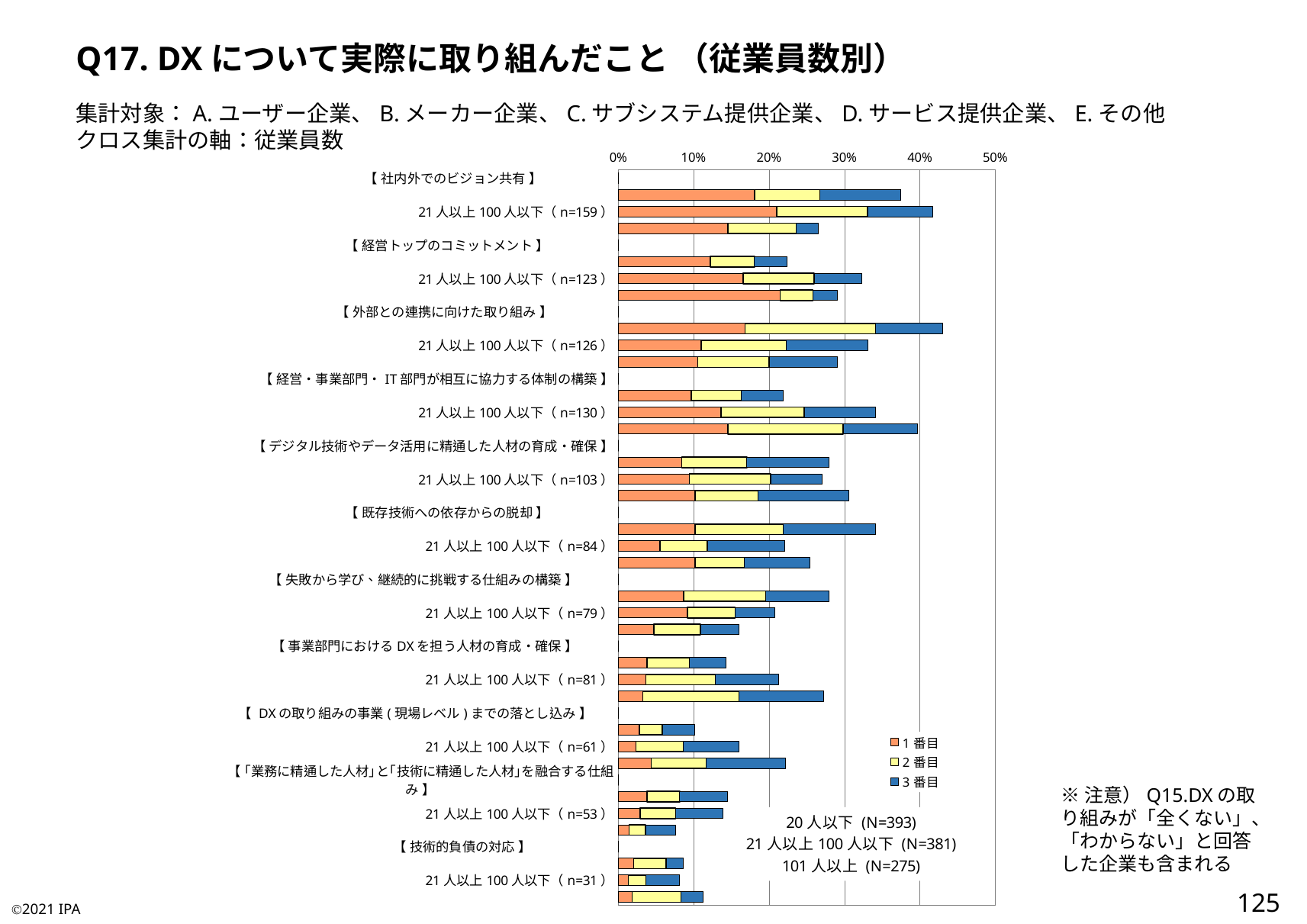
What is the highest value shown on the horizontal axis of the chart? 50% Is the total bar length for 21人以上100人以下 (n=61) under 【DXの取り組みの事業(現場レベル)までの落とし込み】 greater or less than 20%? less Is the total bar length for 21人以上100人以下 (n=31) under 【技術的負債の対応】 greater or less than 10%? less Among the labeled 21人以上100人以下 bars, which category group has the longest total bar? 社内外でのビジョン共有 What kind of chart is shown on the slide? Stacked bar chart Which has the longer total bar: 21人以上100人以下 (n=159) under 【社内外でのビジョン共有】 or 21人以上100人以下 (n=123) under 【経営トップのコミットメント】? 21人以上100人以下 (n=159) under 社内外でのビジョン共有 How many bracketed category groups (【 】) are shown on the chart? 11 How many series does the legend list? 3 Is the total bar length for 21人以上100人以下 (n=159) under 【社内外でのビジョン共有】 greater or less than 40%? greater What are the three legend entries of the chart? 1番目, 2番目, 3番目 Among the labeled 21人以上100人以下 bars, which category group has the shortest total bar? 技術的負債の対応